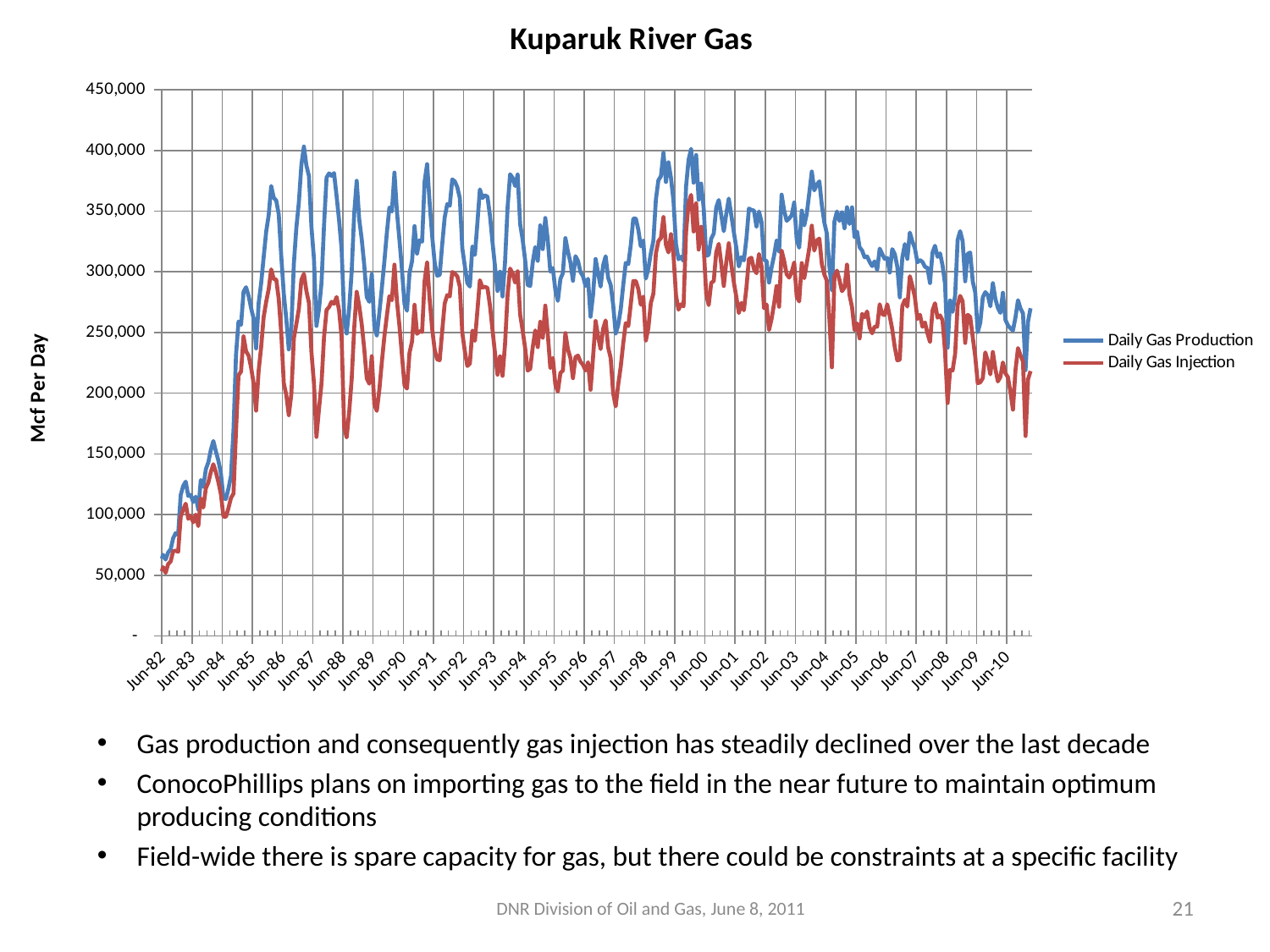
Is the value for Daily Gas Production at Jun-10 greater or less than 300,000? less What is the title of the chart? Kuparuk River Gas How many series does the legend list? 2 Which series reaches the highest value on the chart, Daily Gas Production or Daily Gas Injection? Daily Gas Production Does Daily Gas Production generally rise or fall between Jun-00 and Jun-10? Fall What is the label on the vertical axis? Mcf Per Day At Jun-99, which is larger, Daily Gas Production or Daily Gas Injection? Daily Gas Production What kind of chart is shown on the slide? Line chart Is the value for Daily Gas Injection at Jun-82 greater or less than 100,000? less Is the value for Daily Gas Production at Jun-82 greater or less than 100,000? less